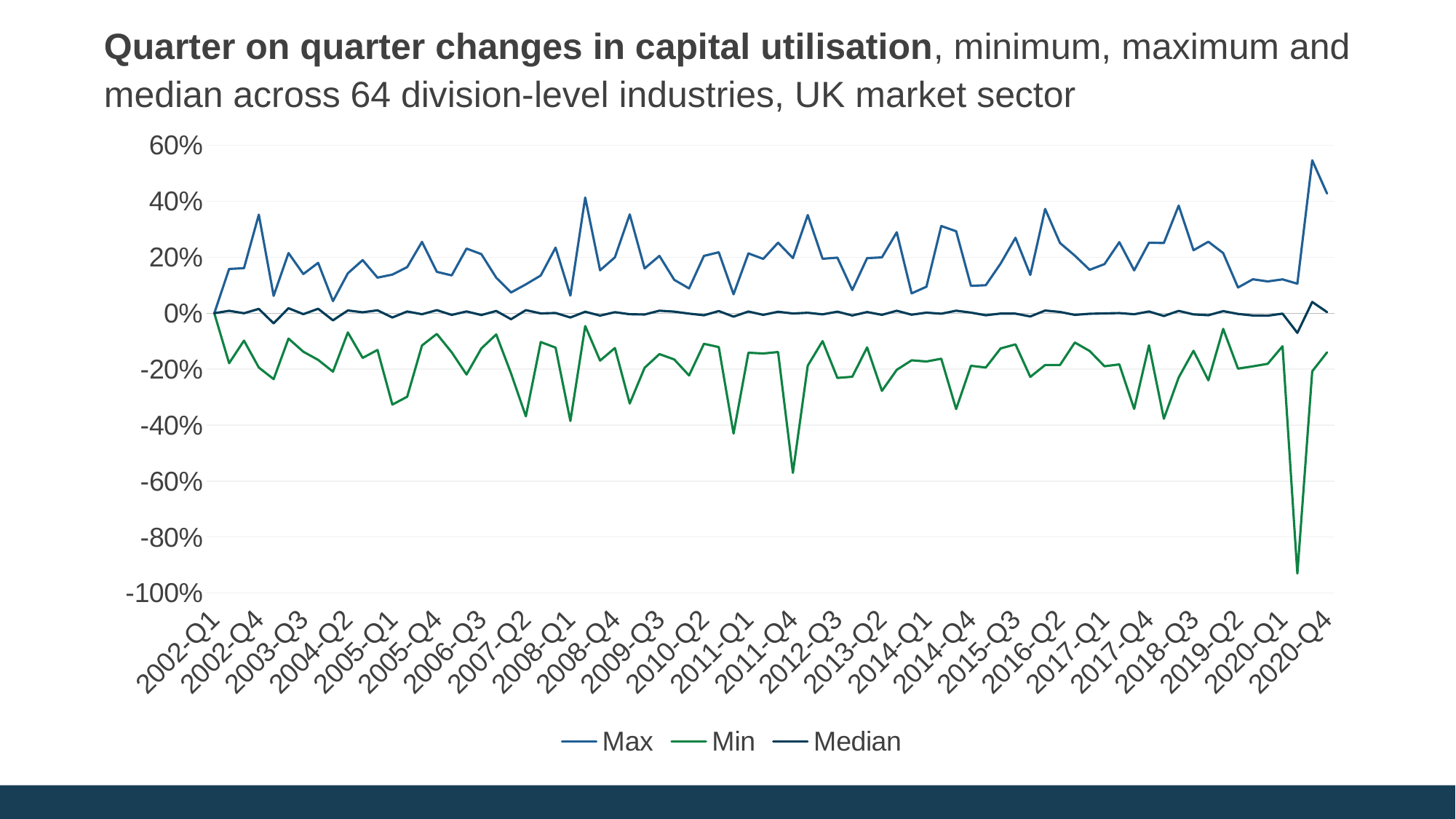
Which is larger at 2020-Q4, the Max series or the Min series? Max Is the highest point of the Max series greater or less than 40%? greater Is the lowest point of the Min series greater or less than -80%? less Does the Max series rise or fall between 2020-Q1 and 2020-Q4? rise What kind of chart is shown on the slide? line chart How many series does the legend list? 3 Is the value of the Max series at 2020-Q4 greater or less than 20%? greater Which series is drawn in green? Min Which series reaches the lowest value anywhere on the chart? Min Which series reaches the highest value anywhere on the chart? Max What are the three series named in the legend? Max, Min, Median